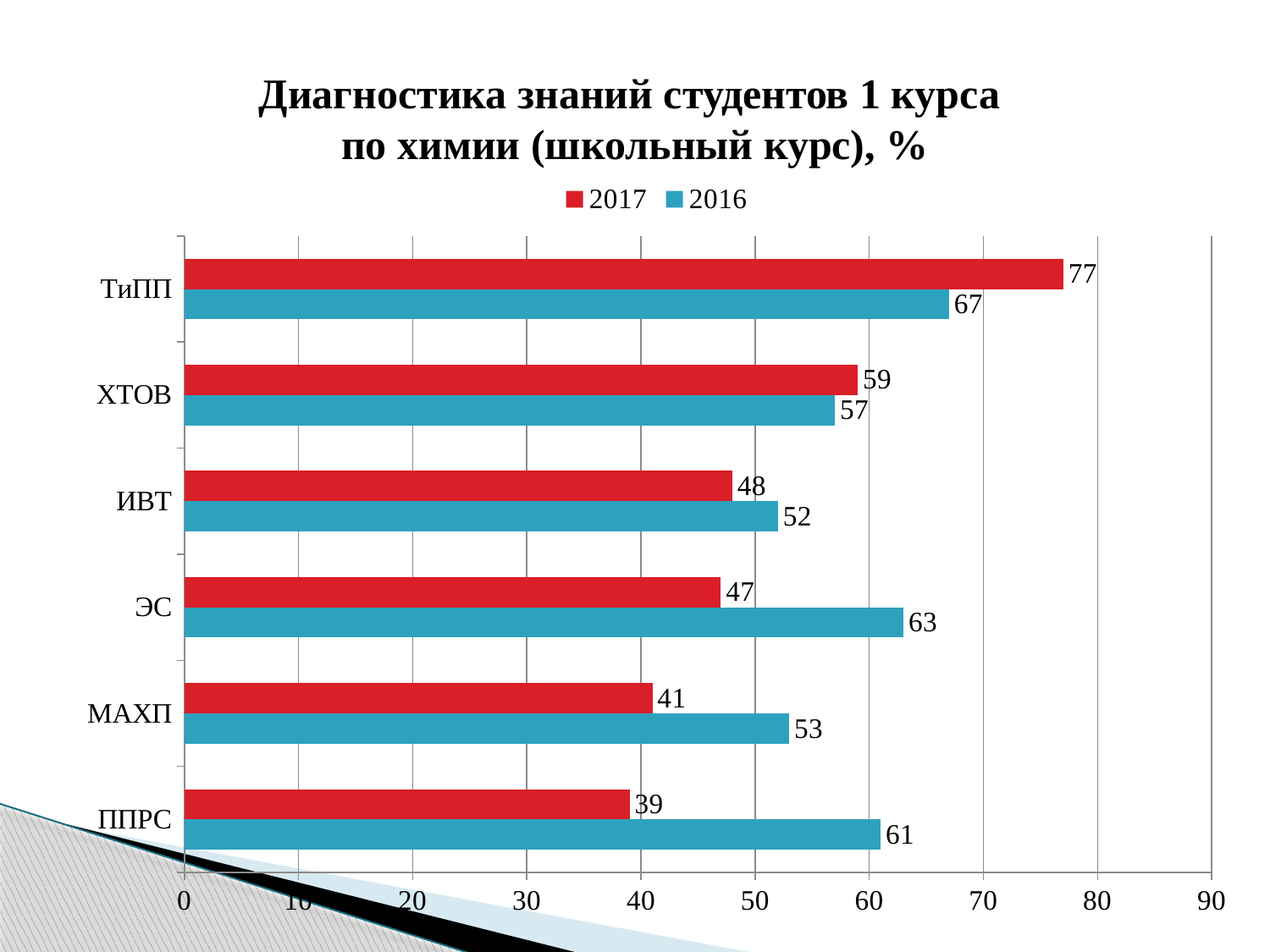
What is the 2017 value for ТиПП? 77 For МАХП, which year has the larger value, 2017 or 2016? 2016 What is the 2016 value for ЭС? 63 What is the difference between the 2017 and 2016 values for ТиПП? 10 How many series does the legend list? 2 Which category has the lowest 2016 value? ИВТ Which category has the highest 2017 value? ТиПП What is the difference between the 2017 and 2016 values for ППРС? 22 Which category has the lowest 2017 value? ППРС What kind of chart is shown on the slide? Bar chart What is the 2016 value for ППРС? 61 How many categories are shown on the chart? 6